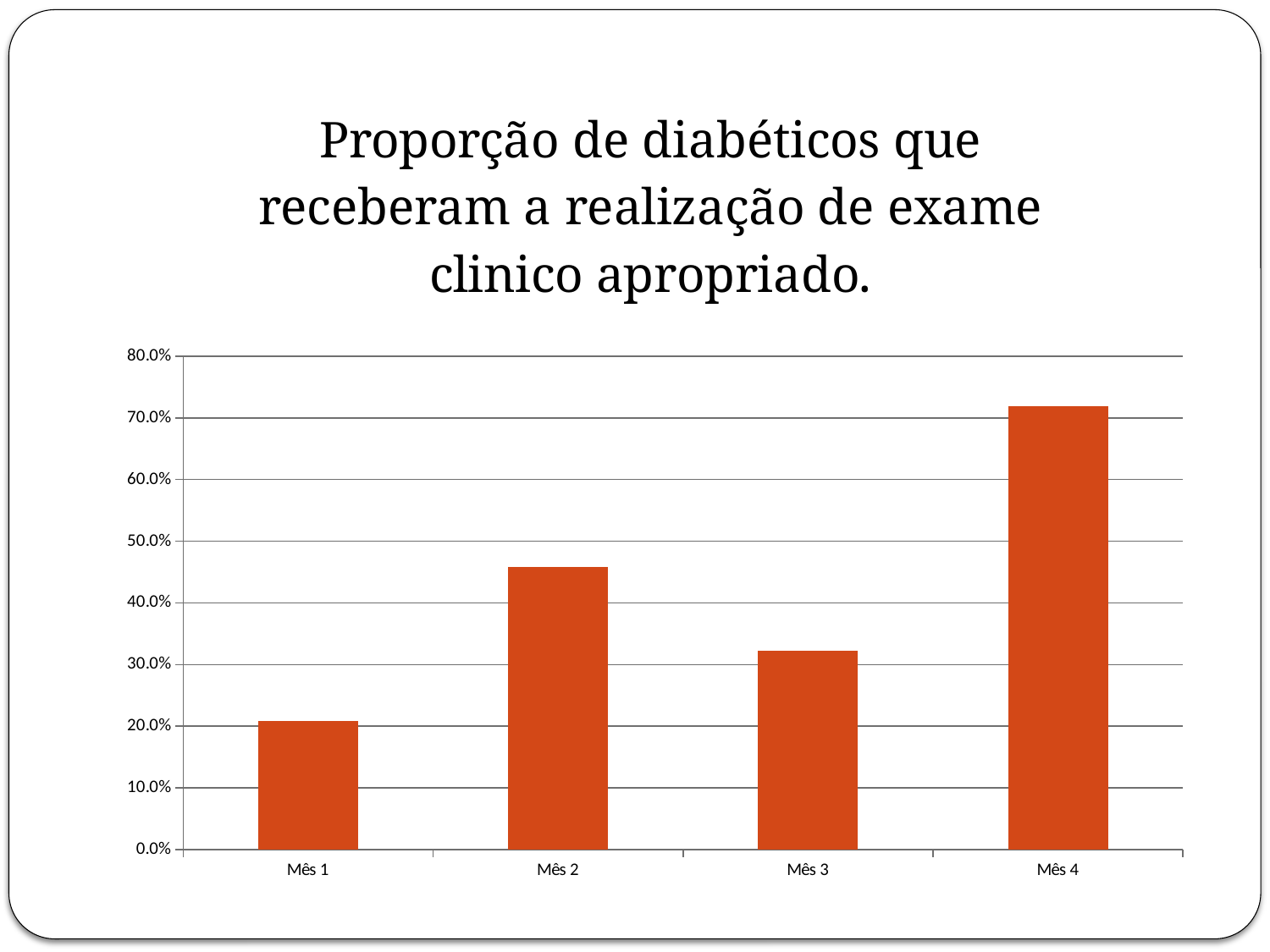
How many categories are shown on the x axis of the chart? 4 Which is larger, the value for Mês 1 or the value for Mês 3? Mês 3 What colour are the bars in the chart? orange What is the title of the slide containing the chart? Proporção de diabéticos que receberam a realização de exame clinico apropriado. Which month has the highest value in the chart? Mês 4 Is the value for Mês 4 greater or less than 70.0%? greater Is the value for Mês 1 greater or less than 30.0%? less Which month has the lowest value in the chart? Mês 1 Is the value for Mês 2 greater or less than 40.0%? greater What kind of chart is shown on the slide? bar chart Which is larger, the value for Mês 2 or the value for Mês 3? Mês 2